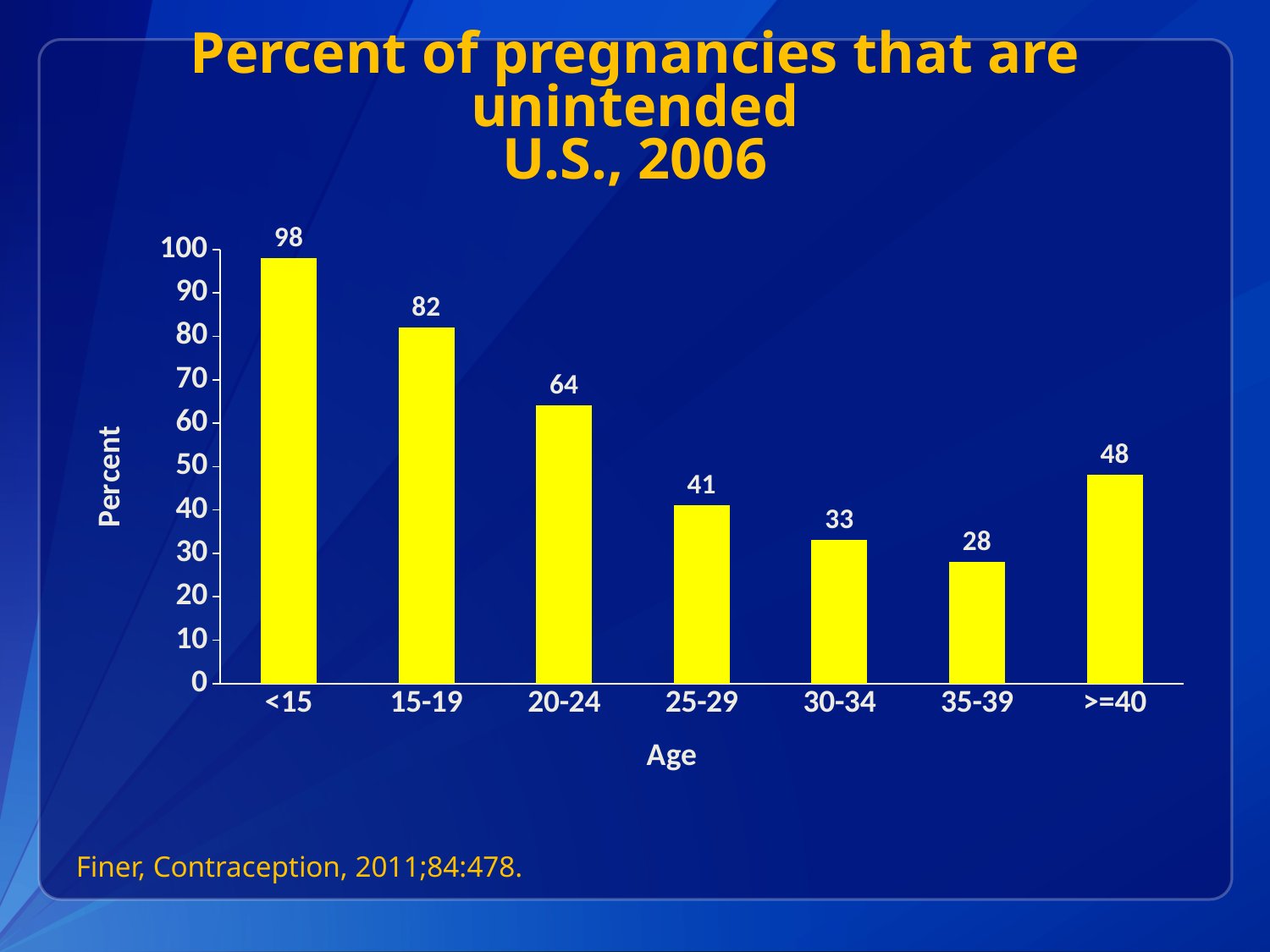
Which age group has the lowest percent of unintended pregnancies? 35-39 What kind of chart is shown on the slide? Bar chart What is the label of the y axis? Percent What is the value shown for the >=40 age group? 48 Is the value for the 20-24 age group greater or less than 50? greater What percent of pregnancies are unintended for the <15 age group? 98 Which has a higher value, the 30-34 age group or the >=40 age group? >=40 How many age groups are shown on the x axis? 7 What is the difference between the values for the 15-19 and 20-24 age groups? 18 What is the value shown for the 25-29 age group? 41 Which age group has the highest percent of unintended pregnancies? <15 What is the difference between the values for the >=40 and 30-34 age groups? 15